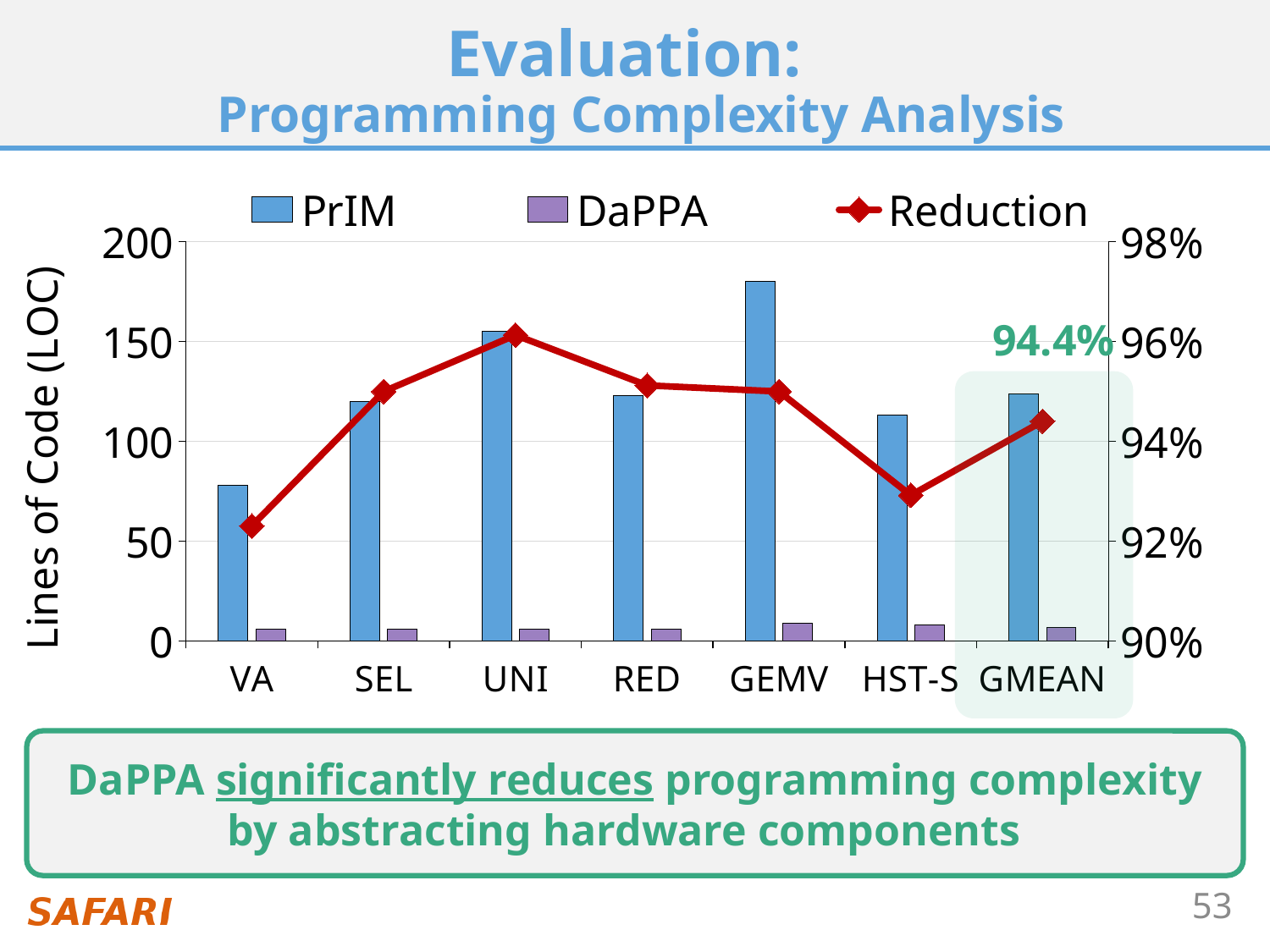
Is the PrIM value for GEMV greater or less than 150? greater Which category has the highest PrIM lines of code? GEMV How many series does the legend list? 3 Which category has the lowest Reduction value? VA Is the PrIM value for VA greater or less than 100? less Which category has the highest Reduction value? UNI What is the label of the left vertical axis? Lines of Code (LOC) Which has more PrIM lines of code, GEMV or HST-S? GEMV How many categories are shown on the x axis? 7 Is the Reduction value for HST-S greater or less than 94%? less What is the Reduction value shown for GMEAN? 94.4% Which category has the lowest PrIM lines of code? VA